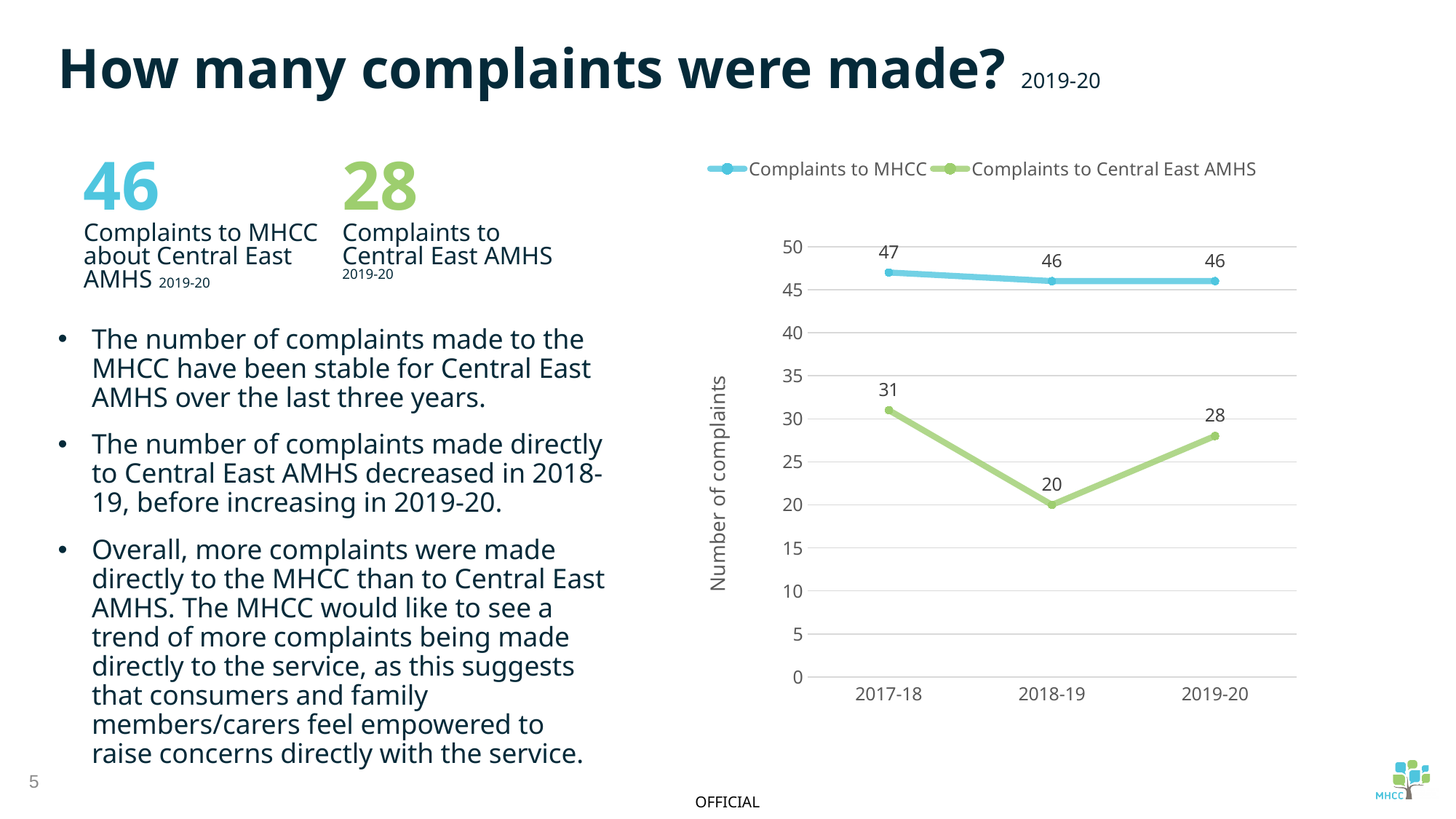
What is the value for Complaints to MHCC in 2017-18? 47 In which year were Complaints to Central East AMHS lowest? 2018-19 What is the value for Complaints to Central East AMHS in 2019-20? 28 How many years are plotted along the x axis? 3 In which year were Complaints to MHCC highest? 2017-18 Do the values for Complaints to MHCC rise or fall from 2017-18 to 2018-19? fall What is the difference between Complaints to MHCC and Complaints to Central East AMHS in 2019-20? 18 How many series does the legend list? 2 What kind of chart is shown on the slide? line chart What is the value for Complaints to Central East AMHS in 2018-19? 20 What is the label on the y axis? Number of complaints Which series has the larger value in 2018-19, Complaints to MHCC or Complaints to Central East AMHS? Complaints to MHCC